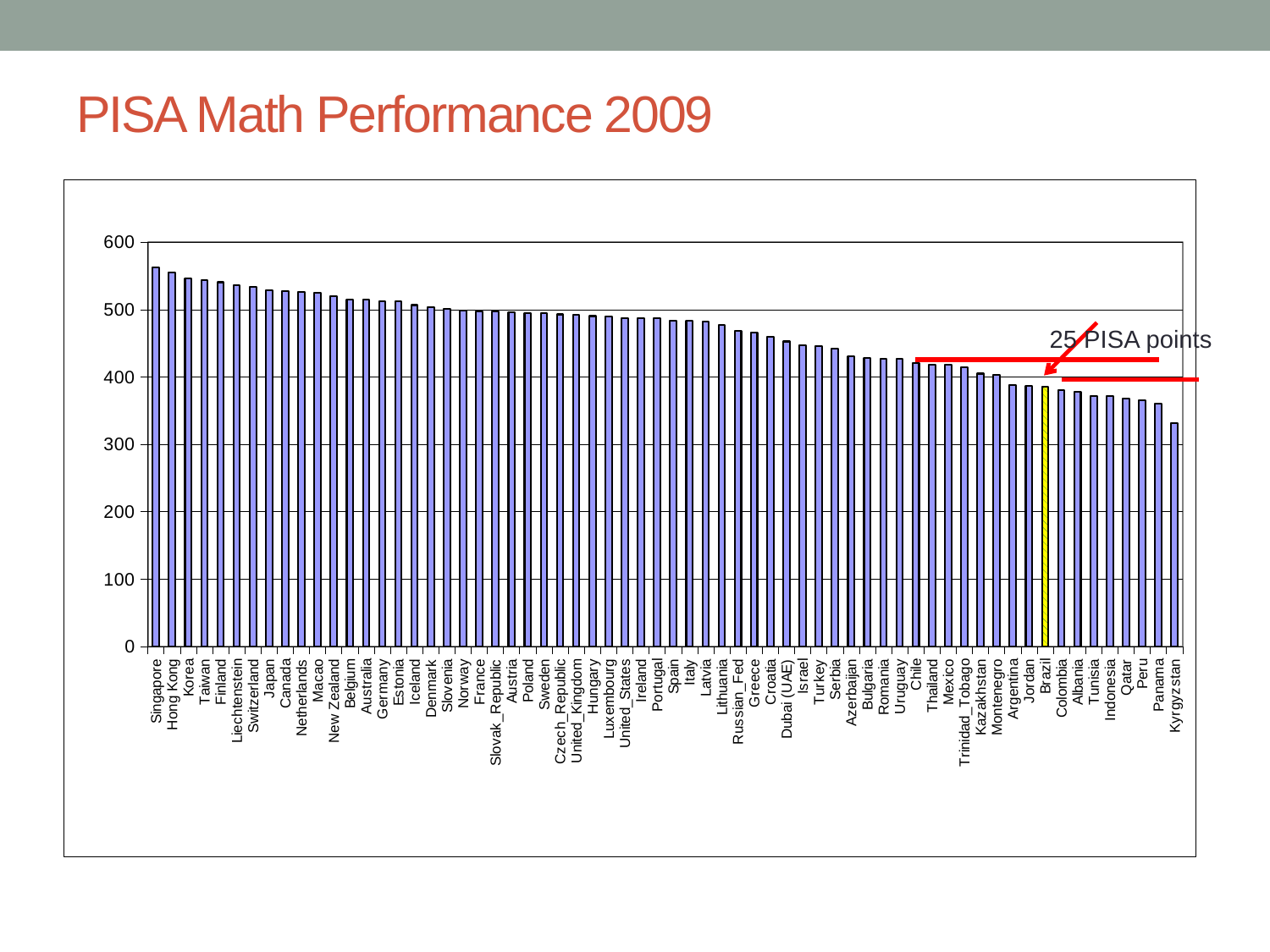
Is the value for Singapore greater or less than 500? greater Which has the larger value, Mexico or Japan? Japan Do the bar values rise or fall moving from left to right along the x axis? fall Is the value for Chile greater or less than 400? greater Which has the larger value, Finland or Brazil? Finland Which country's bar is highlighted in yellow on the chart? Brazil What is the title of the chart on the slide? PISA Math Performance 2009 Which country has the lowest PISA math score in the chart? Kyrgyzstan Is the value for Kyrgyzstan greater or less than 400? less What kind of chart is shown on the slide? bar chart Which country has the highest PISA math score in the chart? Singapore